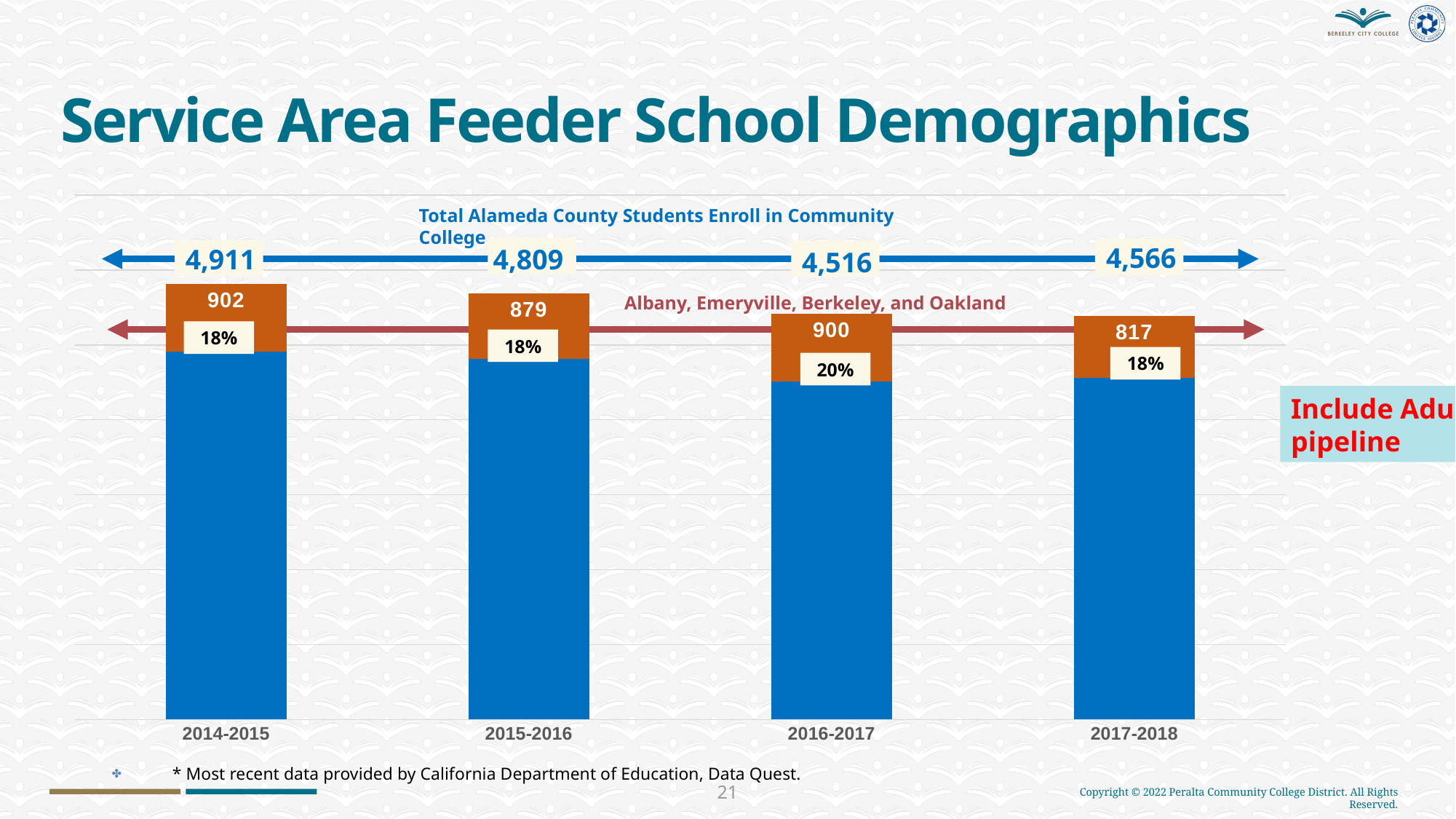
What percentage is shown for 2016-2017? 20% What is the difference between the Albany, Emeryville, Berkeley, and Oakland values for 2014-2015 and 2017-2018? 85 Which year has the larger total of Alameda County students, 2016-2017 or 2017-2018? 2017-2018 Which year has the lowest total of Alameda County students enrolled in community college? 2016-2017 Which year has the highest number of students from Albany, Emeryville, Berkeley, and Oakland? 2014-2015 Which year has the lowest number of students from Albany, Emeryville, Berkeley, and Oakland? 2017-2018 How many academic years are shown on the chart? 4 What kind of chart is shown on the slide? Stacked bar chart What is the total number of Alameda County students enrolled in community college in 2014-2015? 4,911 Does the total number of Alameda County students rise or fall from 2014-2015 to 2016-2017? Fall What is the number of students from Albany, Emeryville, Berkeley, and Oakland in 2016-2017? 900 What is the total number of Alameda County students enrolled in community college in 2017-2018? 4,566